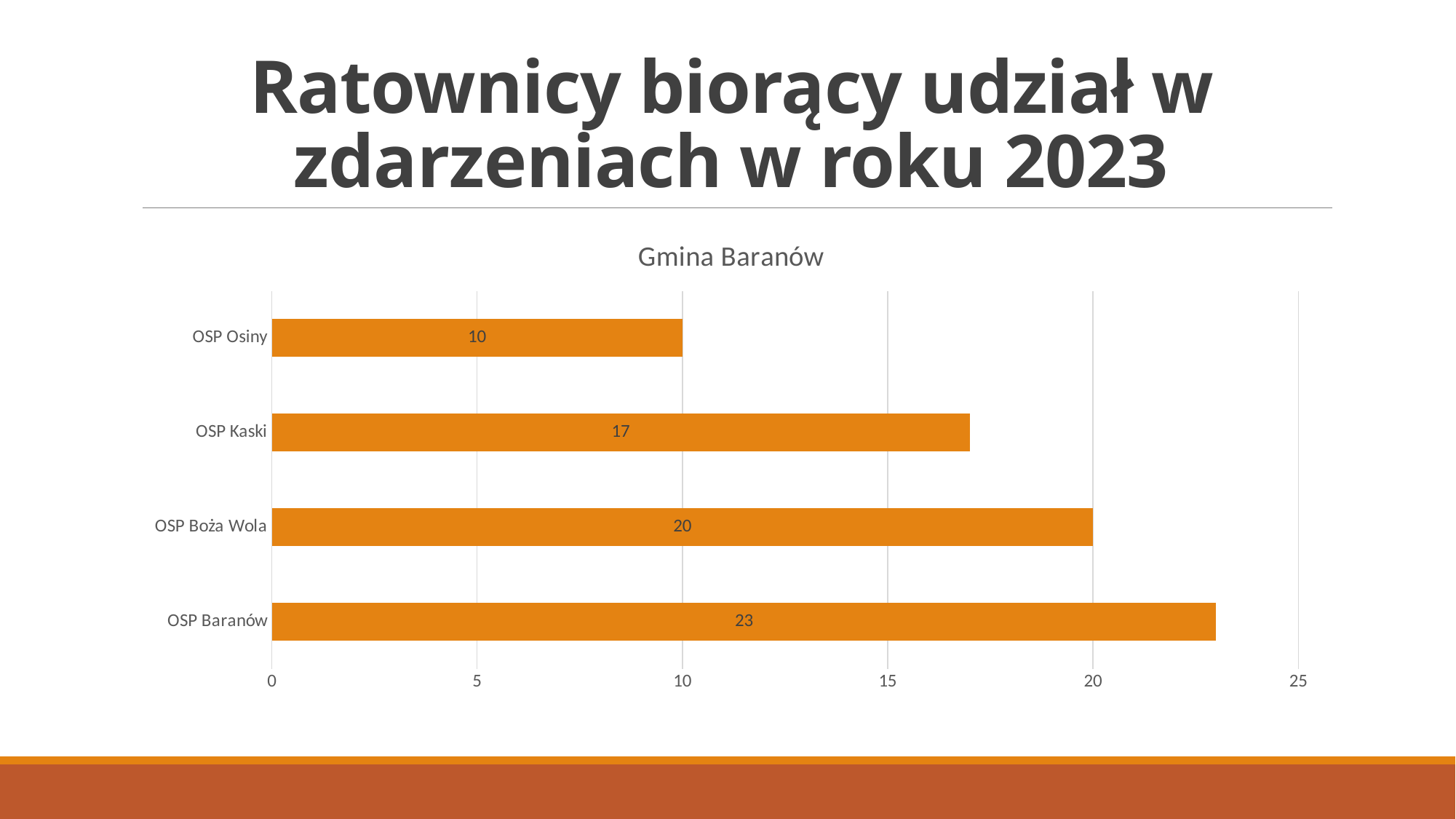
Which category has the highest value? OSP Baranów Which is larger, the value for OSP Kaski or the value for OSP Boża Wola? OSP Boża Wola How many categories are shown in the chart? 4 What is the value for OSP Baranów? 23 What is the value for OSP Osiny? 10 Is the value for OSP Kaski greater or less than 15? greater What is the value for OSP Boża Wola? 20 What kind of chart is shown on the slide? bar chart Which category has the lowest value? OSP Osiny What is the difference between the values for OSP Baranów and OSP Osiny? 13 What is the title of the chart? Gmina Baranów What is the value for OSP Kaski? 17